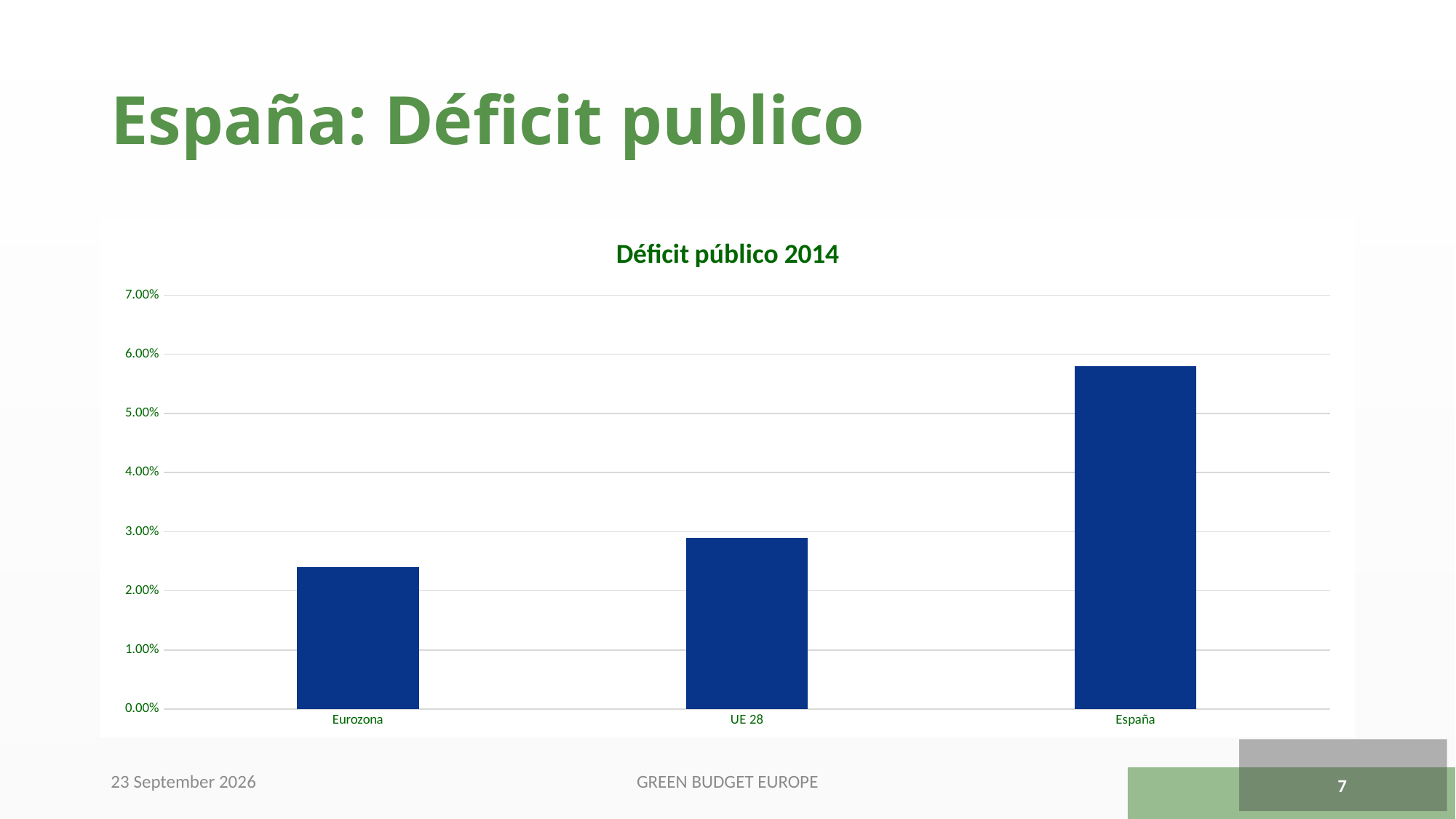
Is the value for UE 28 greater or less than 2.00%? greater Which has a larger value, Eurozona or UE 28? UE 28 Do the values rise or fall from left to right along the x axis? rise Is the value for Eurozona greater or less than 3.00%? less Which category has the highest value in the chart? España How many categories are shown on the x axis of the chart? 3 What is the title of the chart? Déficit público 2014 Which has a larger value, UE 28 or España? España Is the value for España greater or less than 5.00%? greater What type of chart is shown on the slide? bar chart Which category has the lowest value in the chart? Eurozona